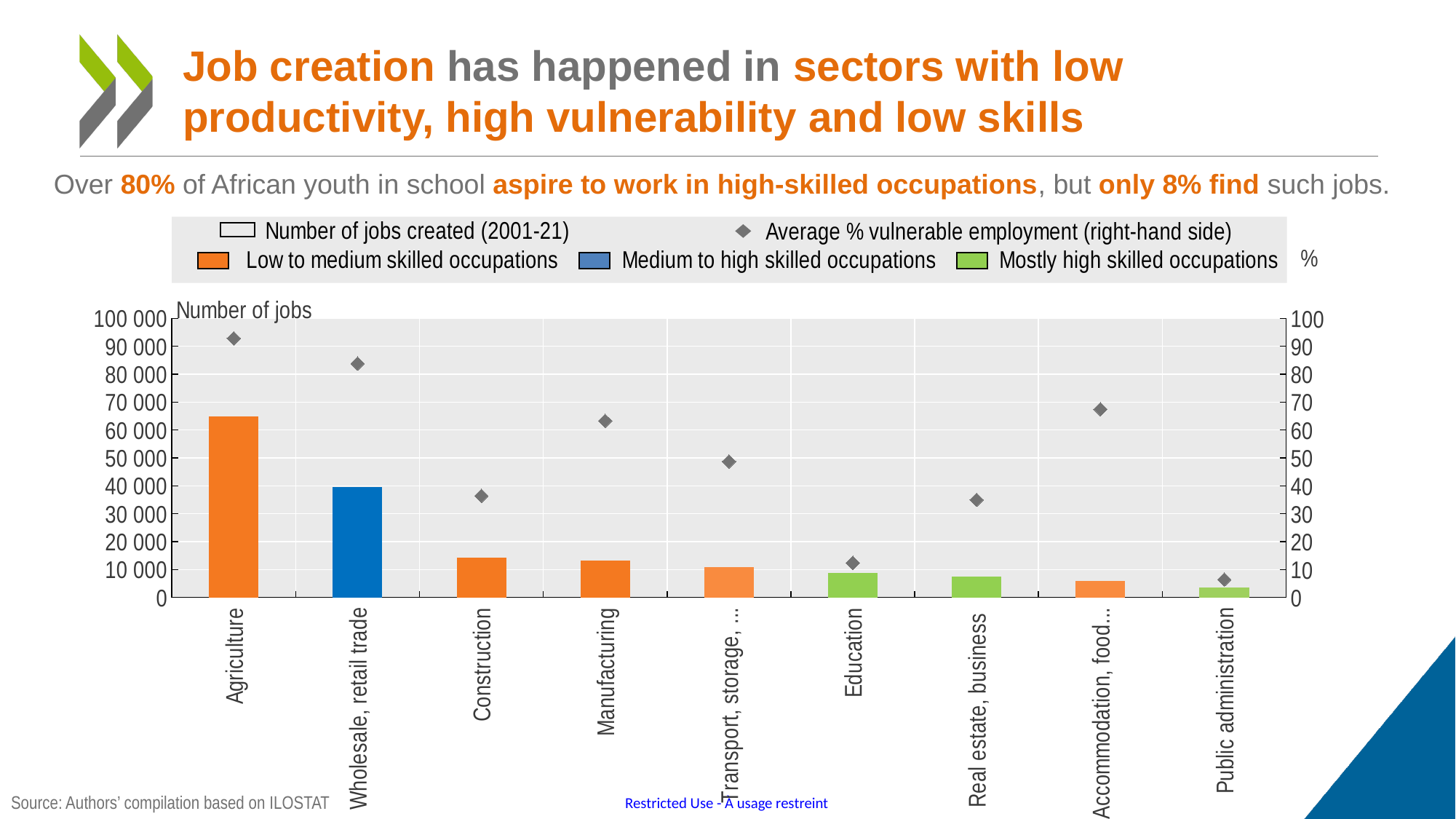
Is the average % vulnerable employment for Agriculture greater or less than 80? greater Is the number of jobs created in Construction greater or less than 20 000? less Which sector's bar is coloured blue, indicating medium to high skilled occupations? Wholesale, retail trade Which sector has the highest average % vulnerable employment? Agriculture Which sector has the lowest average % vulnerable employment? Public administration Is the number of jobs created in Agriculture greater or less than 60 000? greater Which has a higher average % vulnerable employment, Manufacturing or Construction? Manufacturing Which sector has the lowest number of jobs created? Public administration How many sectors are shown on the x axis? 9 Do the number-of-jobs bars rise or fall from left to right across the sectors? fall Which sector has the highest number of jobs created? Agriculture